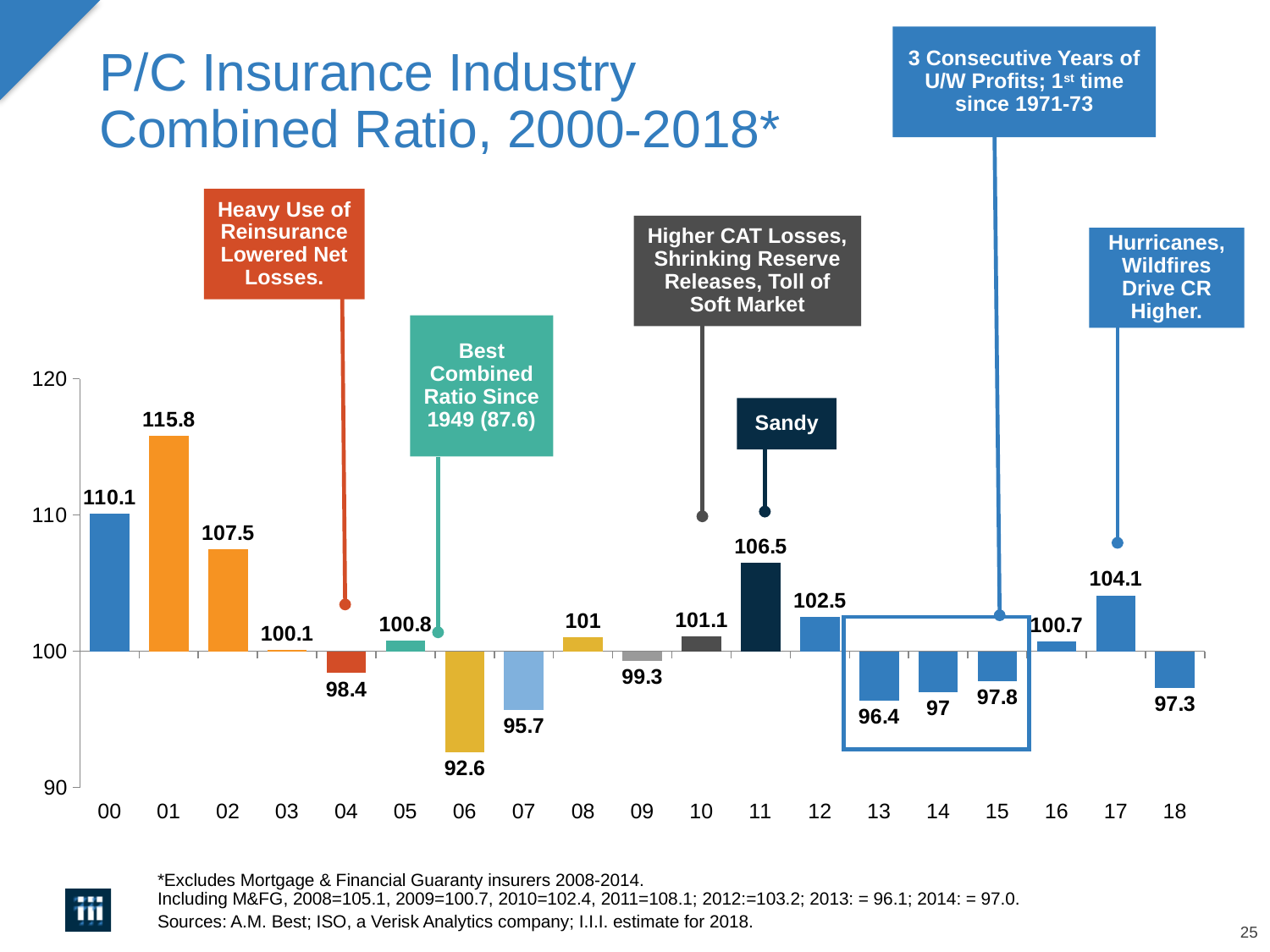
What kind of chart is shown on the slide? bar chart What is the combined ratio for 2018? 97.3 Which year has the lowest combined ratio? 06 Is the value for 2007 greater or less than 100? less Do the combined ratio values rise or fall from 2013 to 2015? rise What is the difference between the combined ratio in 2001 and in 2000? 5.7 How many years are shown on the x axis? 19 What is the difference between the combined ratio in 2017 and in 2018? 6.8 What is the combined ratio for 2006? 92.6 What is the combined ratio for 2001? 115.8 Which year has the highest combined ratio? 01 Which year has the larger combined ratio, 2011 or 2012? 11